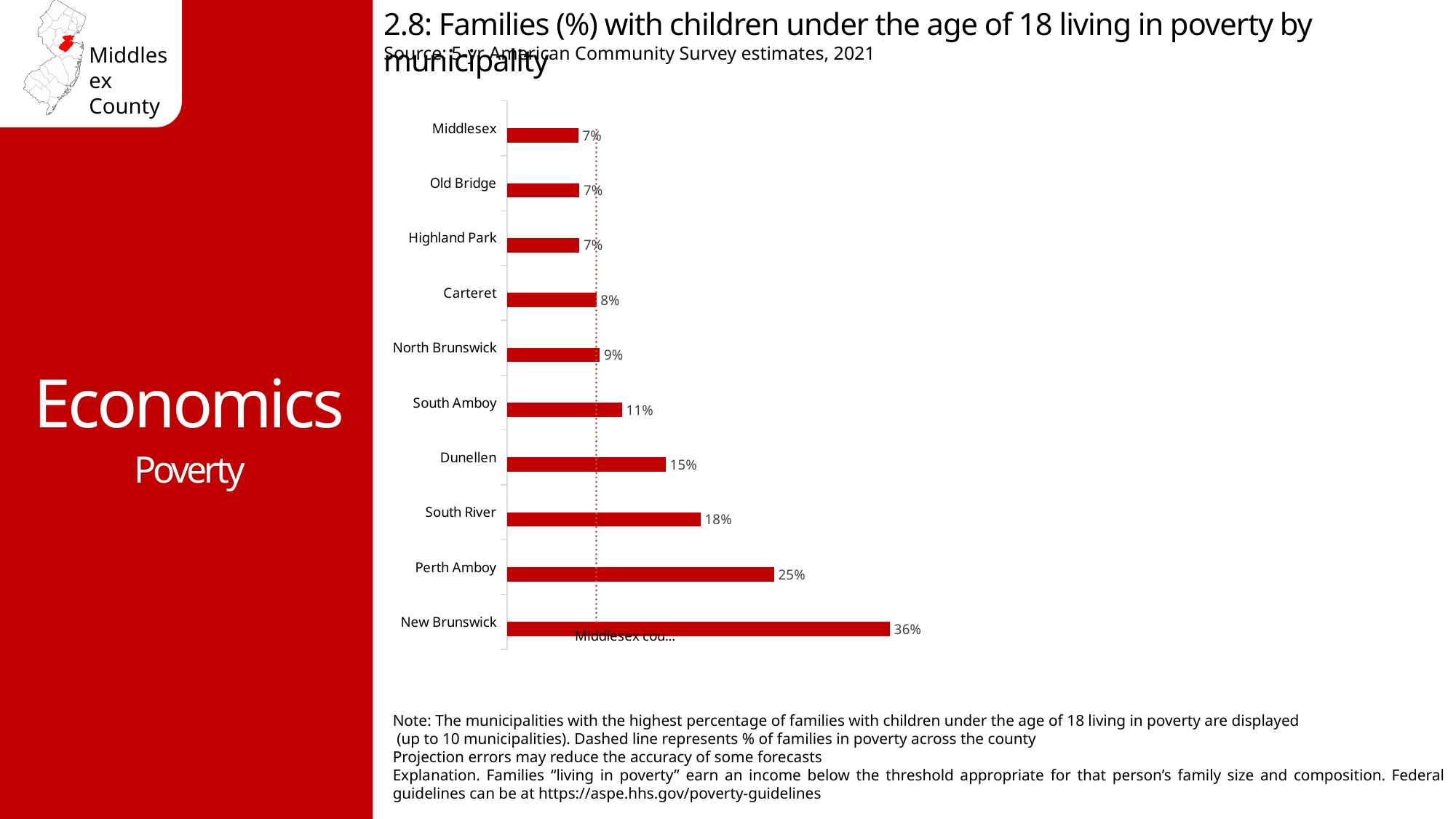
Which is larger, the value for Dunellen or the value for Carteret? Dunellen What is the value for North Brunswick? 9% What is the difference between the values for New Brunswick and Perth Amboy? 11% Which municipality has the highest percentage of families with children under 18 living in poverty? New Brunswick What does the dashed vertical line in the chart represent? % of families in poverty across the county How many municipalities are shown in the chart? 10 What is the value for Dunellen? 15% What is the value for New Brunswick? 36% Which is larger, the value for South River or the value for Perth Amboy? Perth Amboy What is the difference between the values for South River and South Amboy? 7% What is the value for Perth Amboy? 25% What kind of chart is shown on the slide? Bar chart